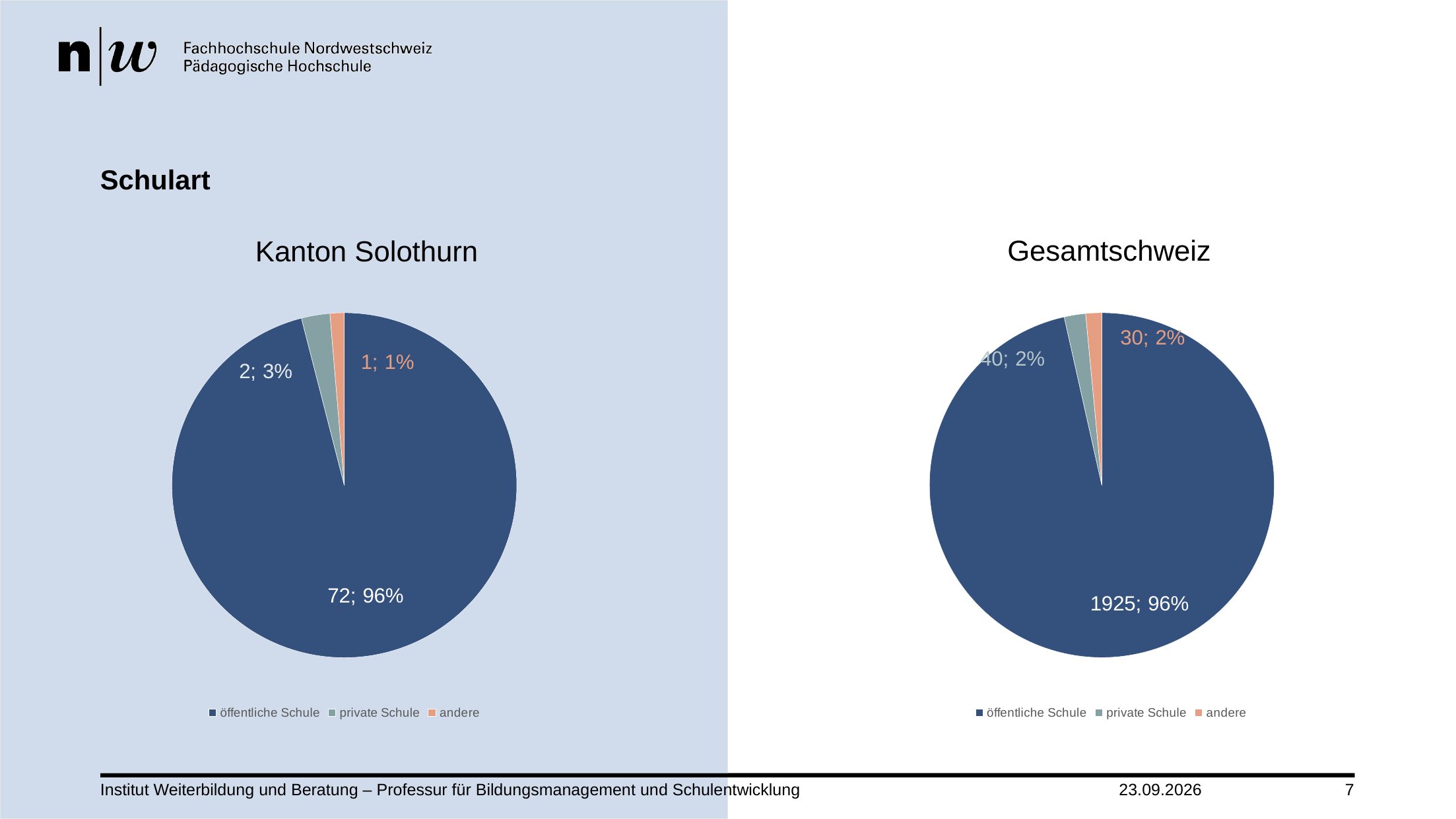
What type of chart is used for Kanton Solothurn? pie chart In the Kanton Solothurn chart, which category has the smallest slice? andere In the Gesamtschweiz chart, what is the count for öffentliche Schule? 1925 In the Kanton Solothurn chart, which category has the largest slice? öffentliche Schule In the Gesamtschweiz chart, what share of the pie is andere? 2% In the Kanton Solothurn chart, what share of the pie is private Schule? 3% In the Gesamtschweiz chart, what is the count for private Schule? 40 How many categories does the legend of the Gesamtschweiz chart list? 3 In the Kanton Solothurn chart, what is the count for andere? 1 In the Kanton Solothurn chart, which colour represents andere? orange In the Kanton Solothurn chart, what is the count for öffentliche Schule? 72 In the Gesamtschweiz chart, what is the difference between the counts for private Schule and andere? 10